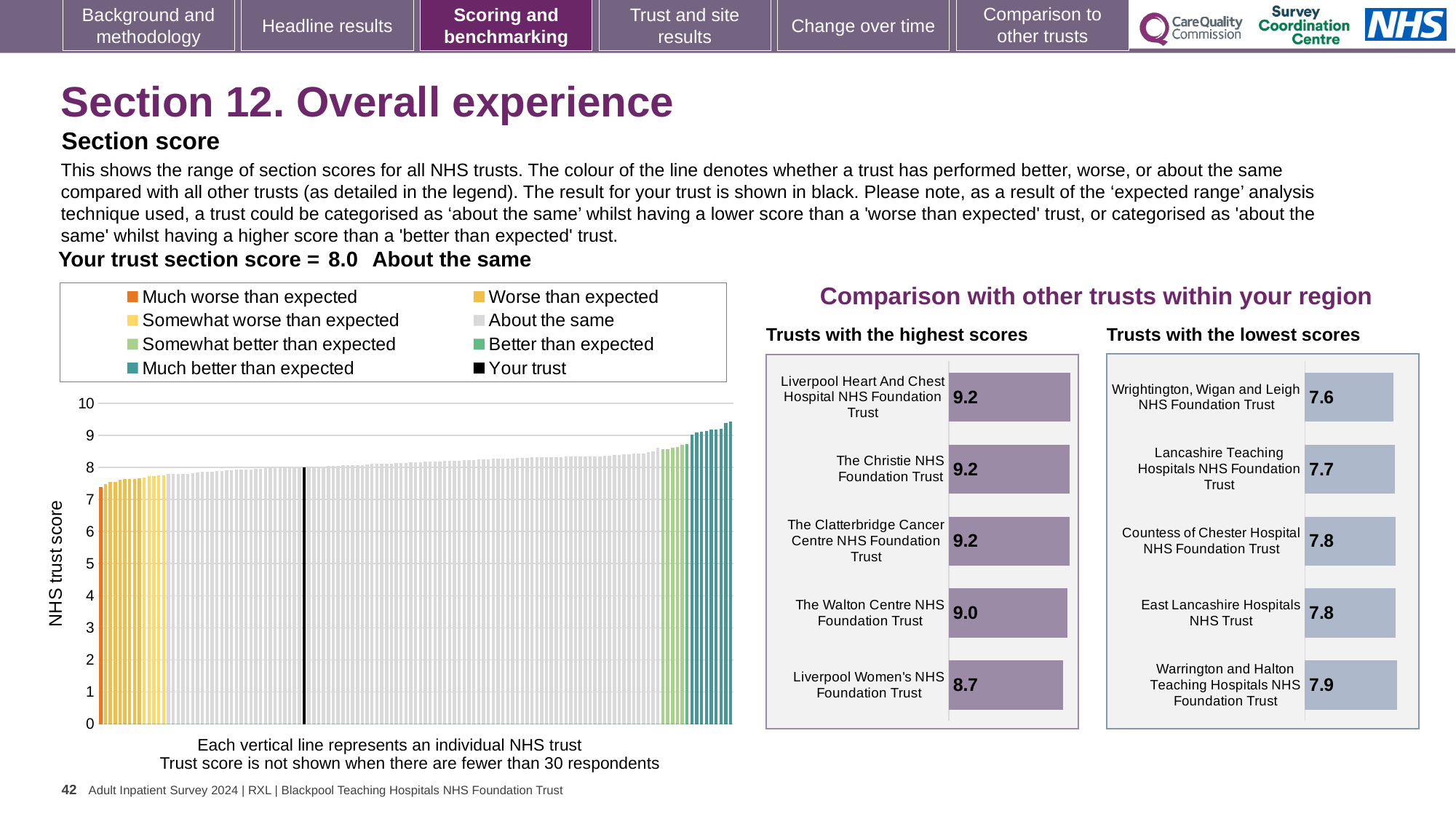
How many entries does the legend of the large chart on the left list? 8 What type of chart is the large chart on the left showing NHS trust scores? Bar chart In the 'Trusts with the highest scores' chart, which trust has the lowest score? Liverpool Women's NHS Foundation Trust In the 'Trusts with the lowest scores' chart, which trust has the lowest score? Wrightington, Wigan and Leigh NHS Foundation Trust How many trusts are shown in the 'Trusts with the highest scores' chart? 5 In the large chart on the left showing NHS trust scores, do the values rise or fall from left to right along the x axis? Rise In the 'Trusts with the lowest scores' chart, which has the higher score: Lancashire Teaching Hospitals NHS Foundation Trust or Countess of Chester Hospital NHS Foundation Trust? Countess of Chester Hospital NHS Foundation Trust In the 'Trusts with the highest scores' chart, what is the score for The Walton Centre NHS Foundation Trust? 9.0 In the 'Trusts with the lowest scores' chart, what is the score for Warrington and Halton Teaching Hospitals NHS Foundation Trust? 7.9 In the 'Trusts with the highest scores' chart, what is the difference between the scores of The Walton Centre NHS Foundation Trust and Liverpool Women's NHS Foundation Trust? 0.3 In the 'Trusts with the lowest scores' chart, what is the score for Wrightington, Wigan and Leigh NHS Foundation Trust? 7.6 In the 'Trusts with the highest scores' chart, what is the score for Liverpool Women's NHS Foundation Trust? 8.7